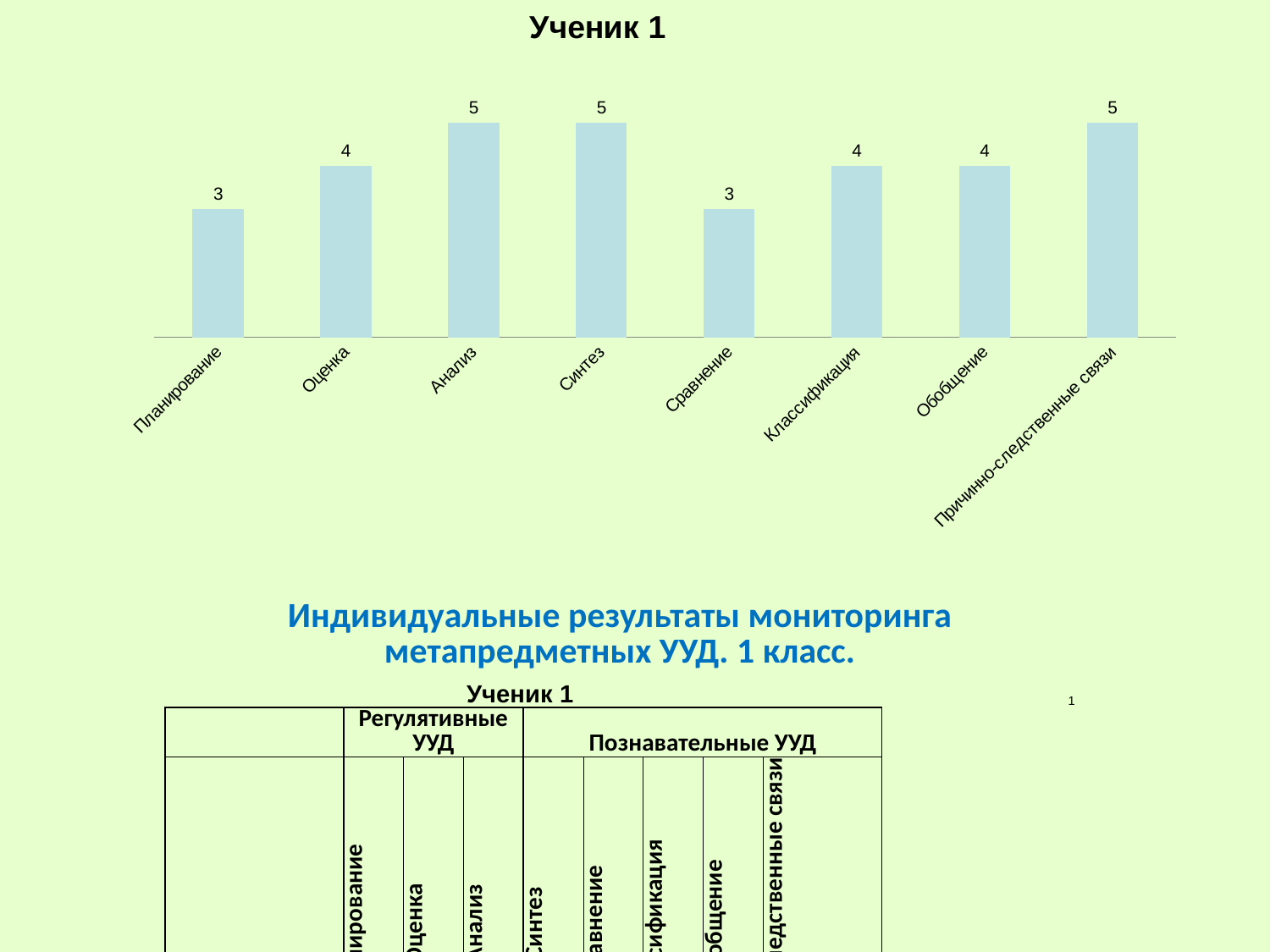
Which has a larger value, Оценка or Анализ? Анализ How many categories are shown on the x axis of the chart? 8 What is the value for Причинно-следственные связи in the chart? 5 What is the value for Сравнение in the chart? 3 What is the title of the chart? Ученик 1 What is the value for Планирование in the chart titled Ученик 1? 3 What kind of chart is shown on the slide? Bar chart Which has a larger value, Сравнение or Обобщение? Обобщение What is the value for Классификация in the chart? 4 What is the value for Анализ in the chart? 5 What is the difference between the values for Синтез and Сравнение? 2 What is the difference between the values for Обобщение and Планирование? 1